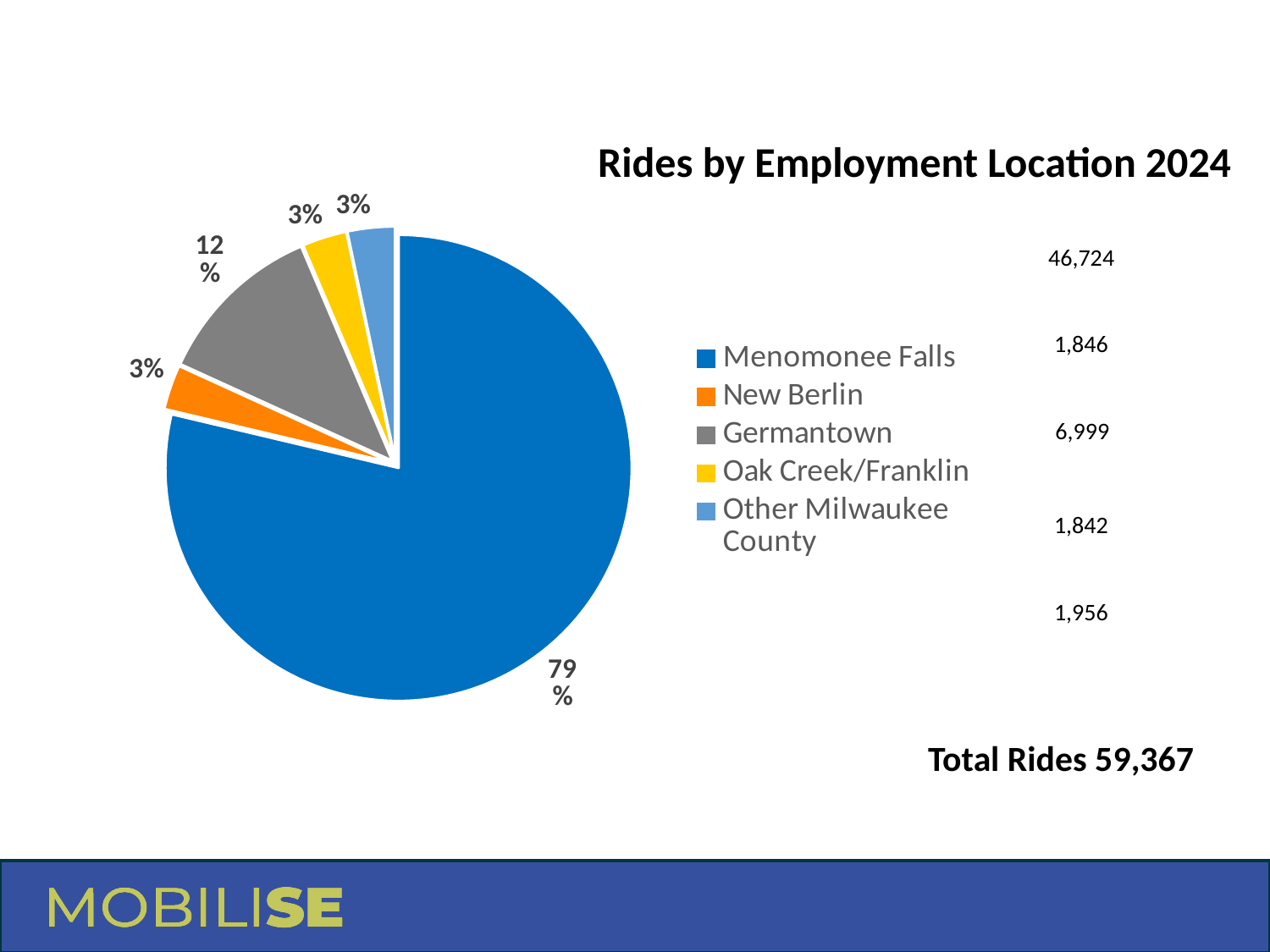
What is the title of the pie chart? Rides by Employment Location 2024 What share of rides does Menomonee Falls account for in the pie chart? 79% How many slices does the pie chart have? 5 What kind of chart is shown on the slide? Pie chart Which employment location has the largest slice of the pie chart? Menomonee Falls What share of rides does New Berlin account for in the pie chart? 3% Which has a larger share of rides, Germantown or New Berlin? Germantown What share of rides does Oak Creek/Franklin account for in the pie chart? 3% What is the total number of rides stated on the slide? 59,367 What colour represents Germantown in the pie chart? Gray By how many percentage points does the Menomonee Falls share exceed the Germantown share? 67 percentage points